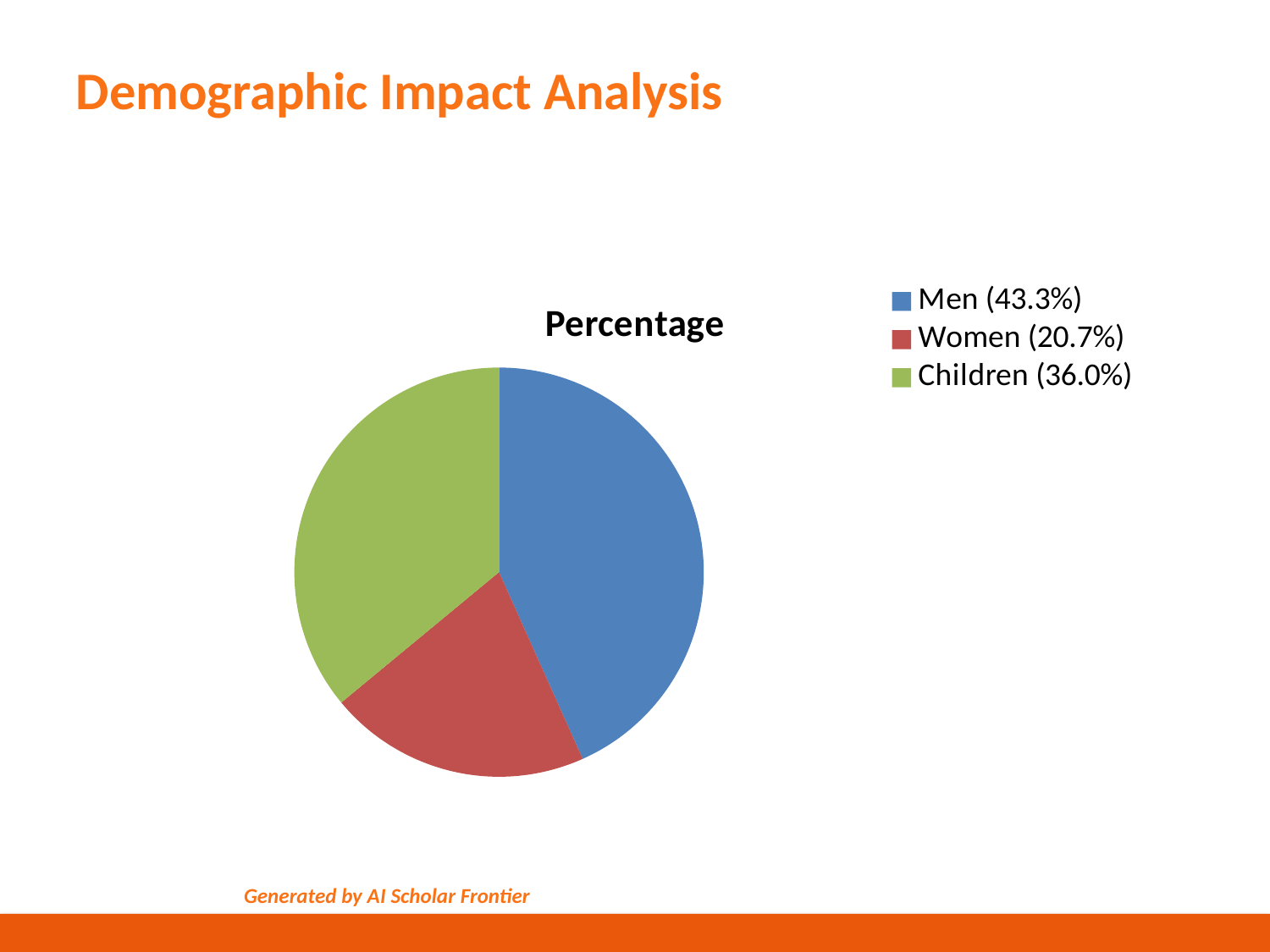
What percentage does the Women slice represent? 20.7% What kind of chart is shown on the slide? pie chart Which category has the largest share of the pie? Men What is the difference in percentage points between the Men share and the Women share? 22.6 What percentage does the Men slice represent? 43.3% What is the title of the chart? Percentage Which category has the smallest share of the pie? Women Which colour represents Children in the pie chart? green What percentage does the Children slice represent? 36.0% Which is larger, the share for Children or the share for Women? Children What is the difference in percentage points between the Men share and the Children share? 7.3 How many slices does the pie chart have? 3